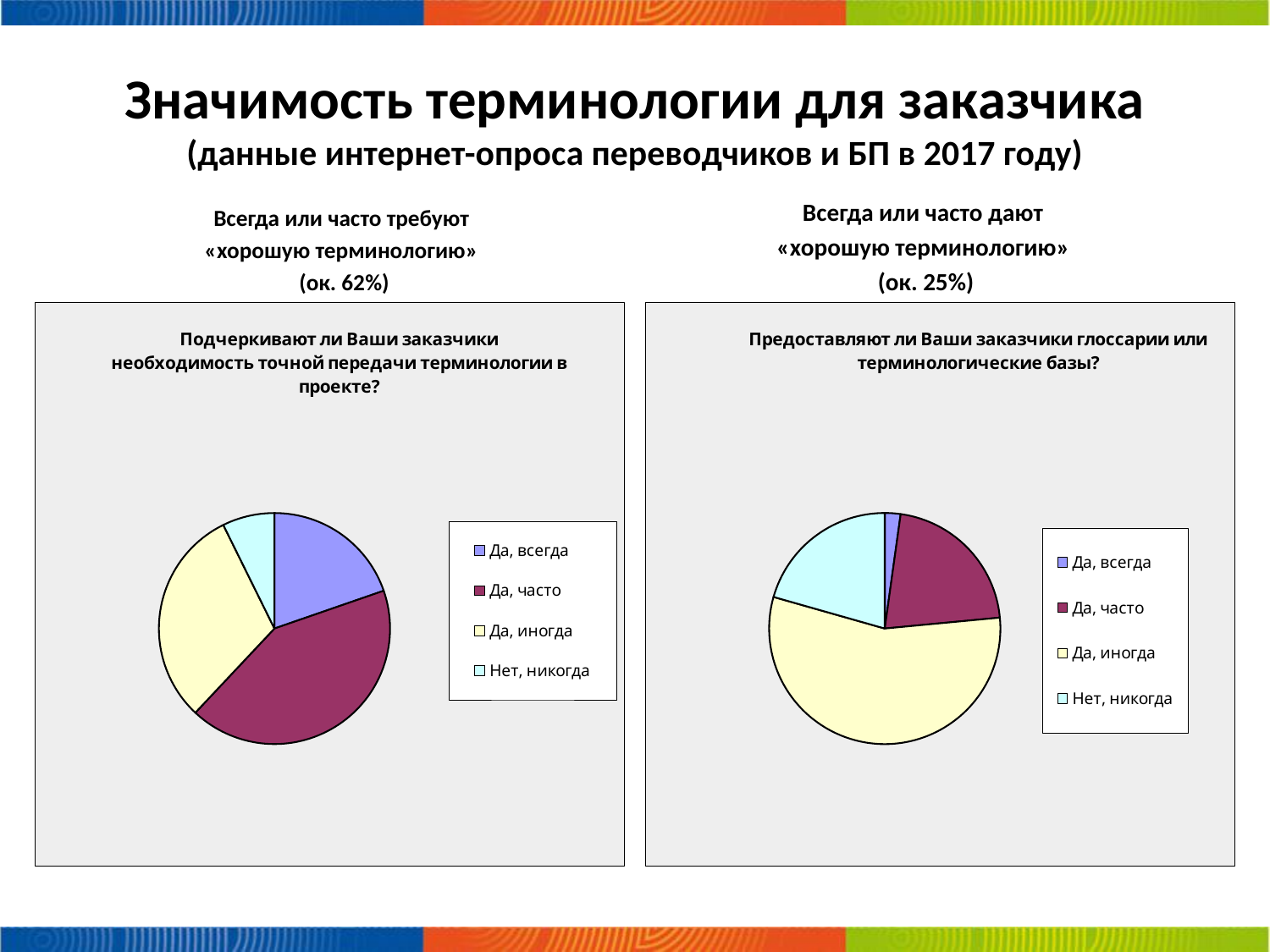
In the left pie chart, which category has the smallest slice? Нет, никогда In the left pie chart, which slice is larger: "Да, часто" or "Да, всегда"? Да, часто What kind of chart is the left chart, titled "Подчеркивают ли Ваши заказчики необходимость точной передачи терминологии в проекте?"? Pie chart What kind of chart is the right chart, titled "Предоставляют ли Ваши заказчики глоссарии или терминологические базы?"? Pie chart In the right pie chart, which slice is larger: "Да, иногда" or "Да, часто"? Да, иногда In the left pie chart, which slice is larger: "Да, иногда" or "Нет, никогда"? Да, иногда In the right pie chart, which category has the smallest slice? Да, всегда In the left pie chart, how many slices are there? 4 What is the title of the right chart? Предоставляют ли Ваши заказчики глоссарии или терминологические базы? In the left pie chart, which category has the largest slice? Да, часто In the right pie chart, which category has the largest slice? Да, иногда In the right pie chart, how many entries does the legend list? 4